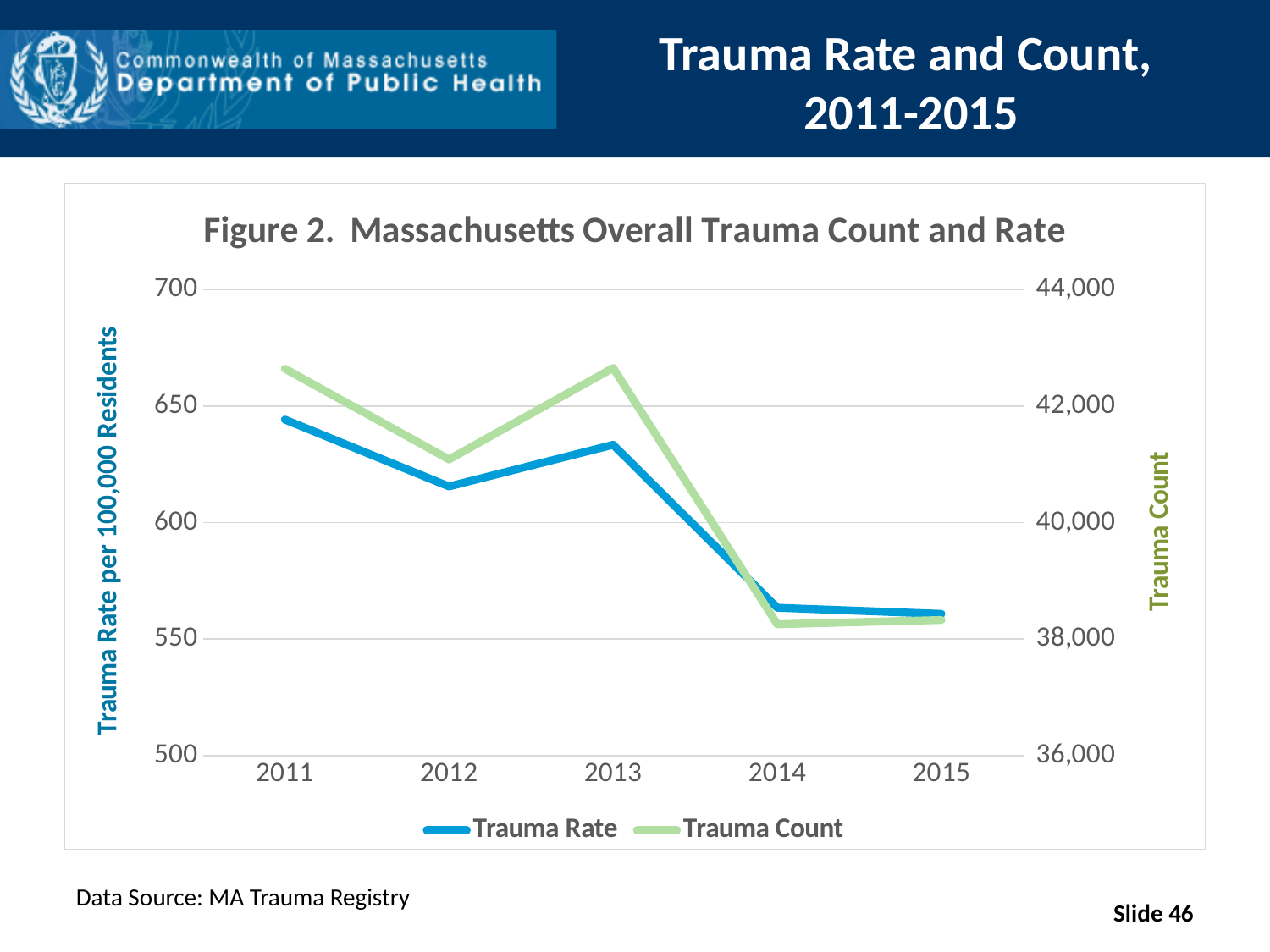
In which year is the Trauma Rate highest? 2011 Does the Trauma Count rise or fall overall from 2011 to 2015? Fall Is the Trauma Rate for 2011 greater or less than 600? greater What is the title of the chart? Figure 2. Massachusetts Overall Trauma Count and Rate Which year has the larger Trauma Rate, 2012 or 2013? 2013 What kind of chart is shown on the slide? Line chart How many series does the legend list? 2 Is the Trauma Count for 2012 greater or less than 40,000? greater Is the Trauma Count for 2015 greater or less than 40,000? less What is the label of the left vertical axis? Trauma Rate per 100,000 Residents How many years are plotted along the x axis? 5